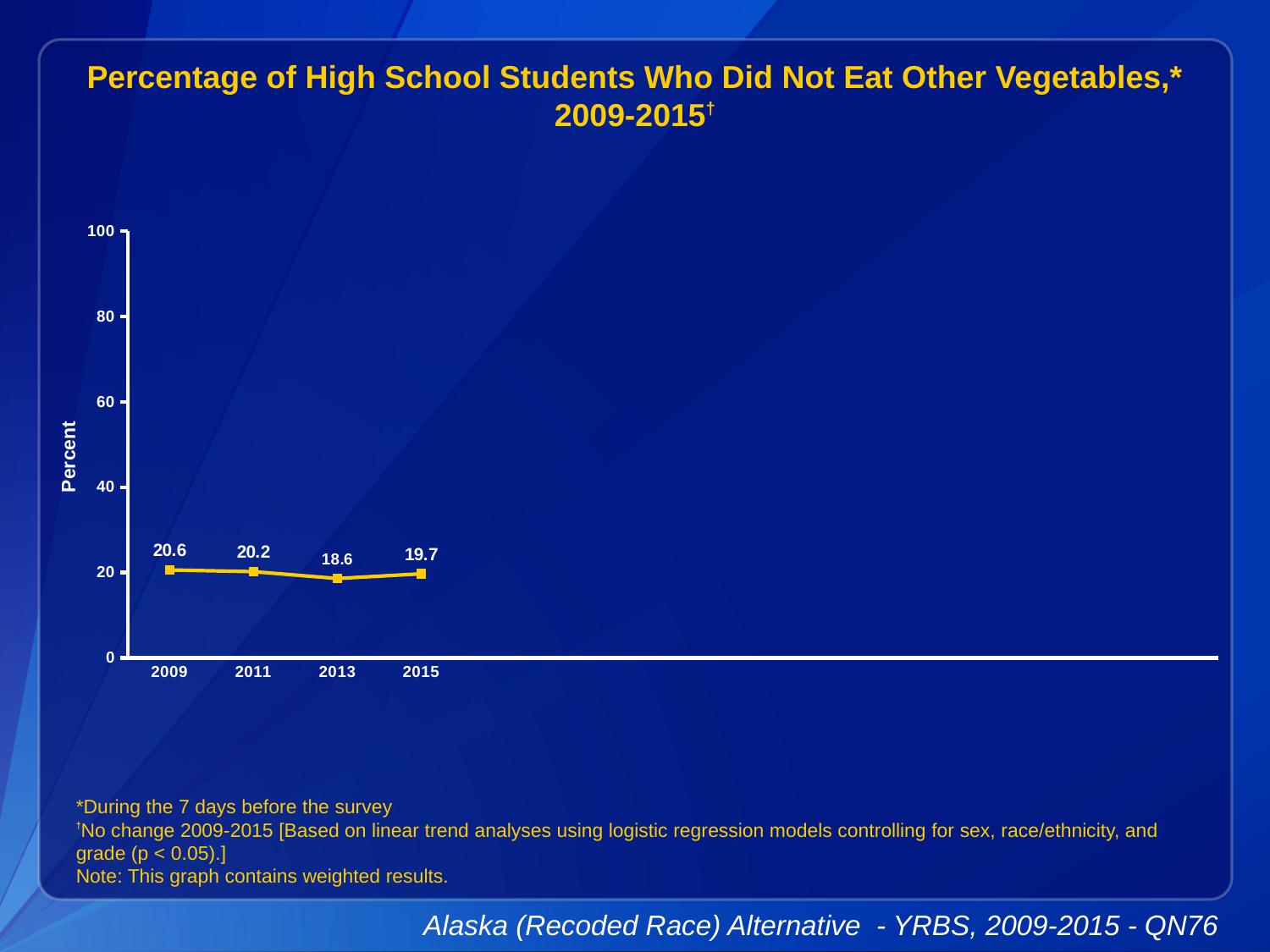
What is the value for 2009? 20.6 What is the maximum value shown on the y axis? 100 Is the value for 2011 greater or less than 40? less What is the difference between the values for 2009 and 2013? 2.0 What is the label on the y axis? Percent Which year has the highest value? 2009 What is the value for 2013? 18.6 What kind of chart is shown? line chart What is the value for 2015? 19.7 How many years are plotted on the chart? 4 Which is larger, the value for 2011 or the value for 2015? 2011 Which year has the lowest value? 2013